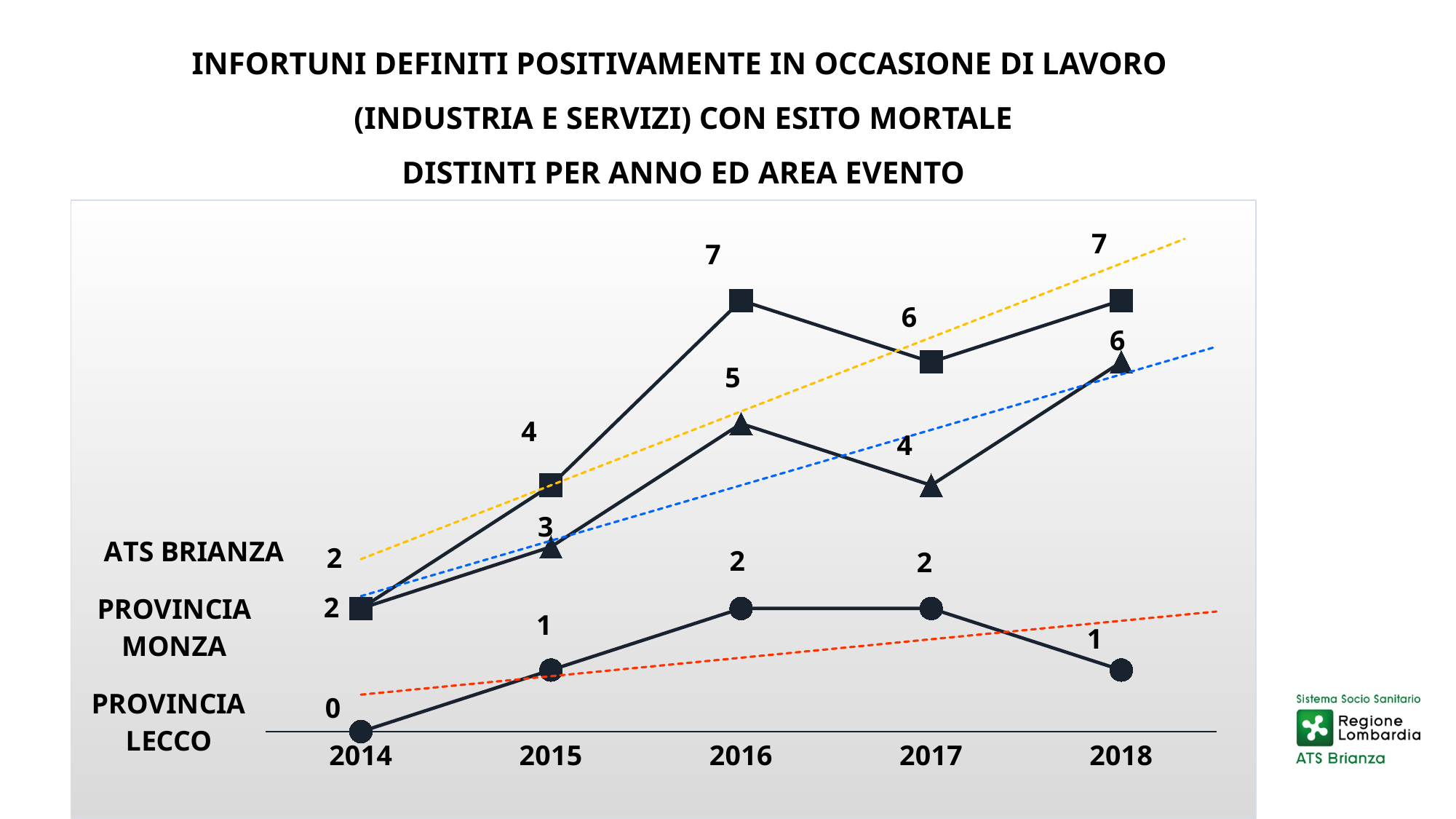
What type of chart is shown on the slide? line chart What is the difference between the ATS BRIANZA value in 2016 and its value in 2014? 5 What is the value for PROVINCIA MONZA in 2018? 6 How many series are labelled on the chart? 3 How many years are shown on the x axis of the chart? 5 Which is larger: the PROVINCIA MONZA value in 2016 or the PROVINCIA LECCO value in 2016? PROVINCIA MONZA What is the value for ATS BRIANZA in 2016? 7 What is the value for PROVINCIA LECCO in 2014? 0 Does the ATS BRIANZA series rise or fall from 2014 to 2016? rise In which year is the value for PROVINCIA MONZA highest? 2018 In which year is the value for PROVINCIA LECCO lowest? 2014 What is the value for PROVINCIA LECCO in 2017? 2